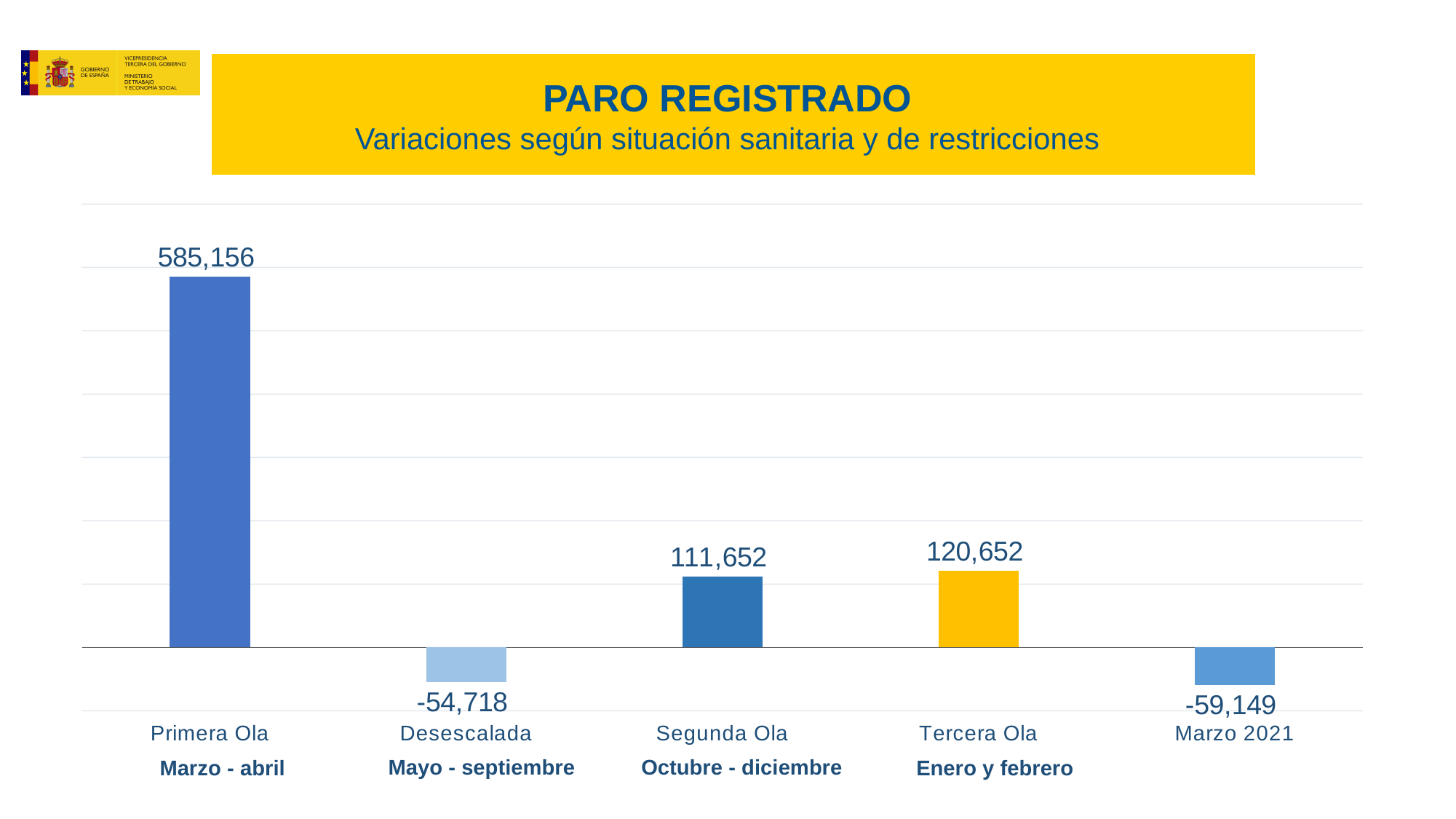
What is the difference between the values for Tercera Ola and Segunda Ola? 9,000 What is the value for Desescalada? -54,718 What is the value for Tercera Ola? 120,652 What is the value for Segunda Ola? 111,652 How many categories are shown on the chart? 5 What is the value for Primera Ola? 585,156 Which is larger, the value for Primera Ola or the value for Tercera Ola? Primera Ola What is the title of the chart? PARO REGISTRADO Which category has the lowest value? Marzo 2021 Which category has the highest value? Primera Ola What is the value for Marzo 2021? -59,149 What kind of chart is shown on the slide? Bar chart